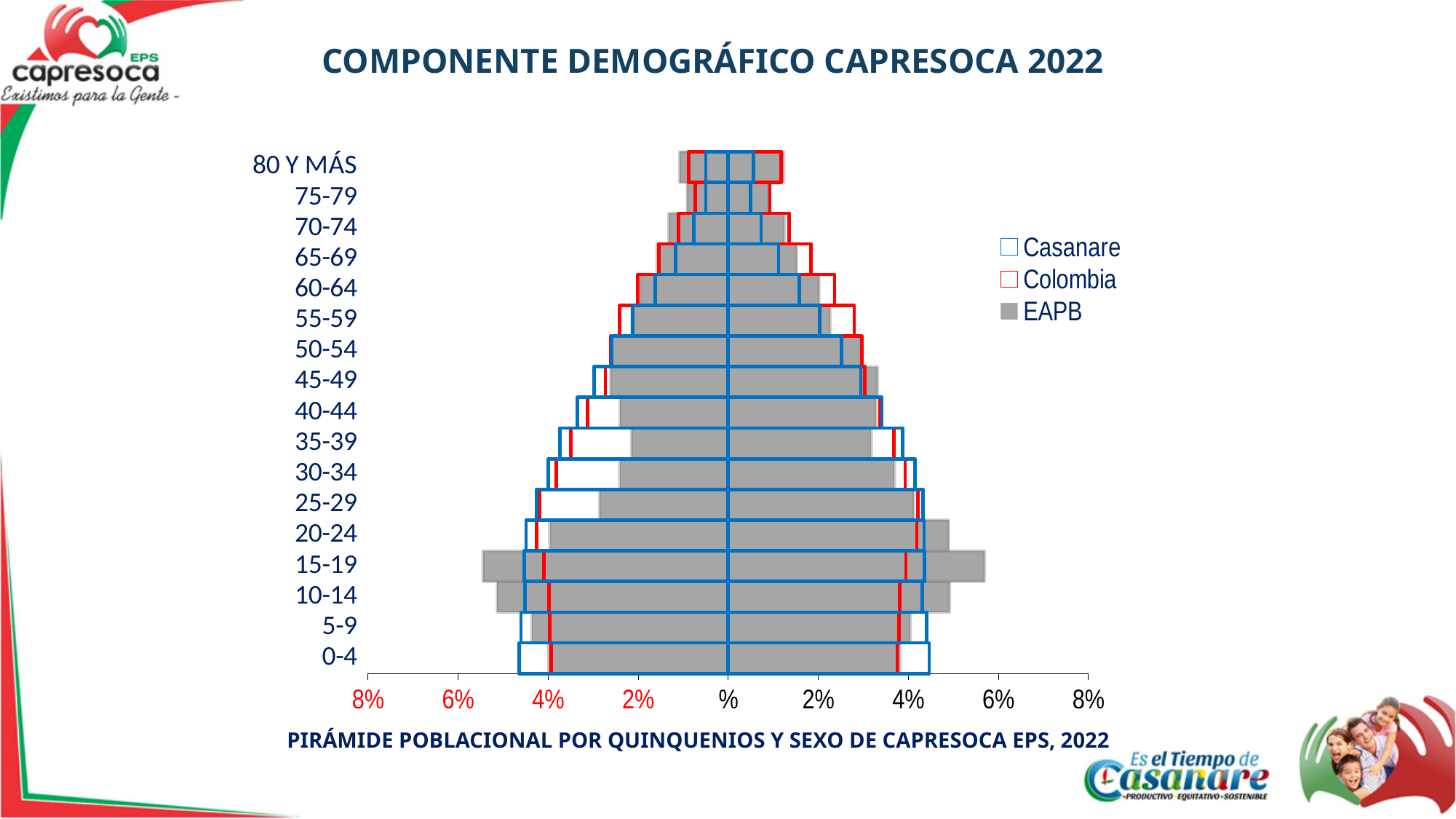
Is the EAPB value for the 25-29 age group on the left side of the pyramid greater or less than 4%? less Is the EAPB value for the 80 Y MÁS age group on the right side of the pyramid greater or less than 2%? less How many age groups are shown on the vertical axis of the pyramid? 17 How many series does the legend list? 3 Which series in the legend is drawn as a solid grey fill? EAPB Which age group has the longest EAPB bar on the right side of the pyramid? 15-19 Is the EAPB value for the 15-19 age group on the right side of the pyramid greater or less than 4%? greater On the right side of the pyramid, which EAPB bar is longer: 15-19 or 80 Y MÁS? 15-19 What kind of chart is shown on the slide? bar chart Moving from the 20-24 age group up to the 75-79 age group, do the EAPB bars get longer or shorter? shorter